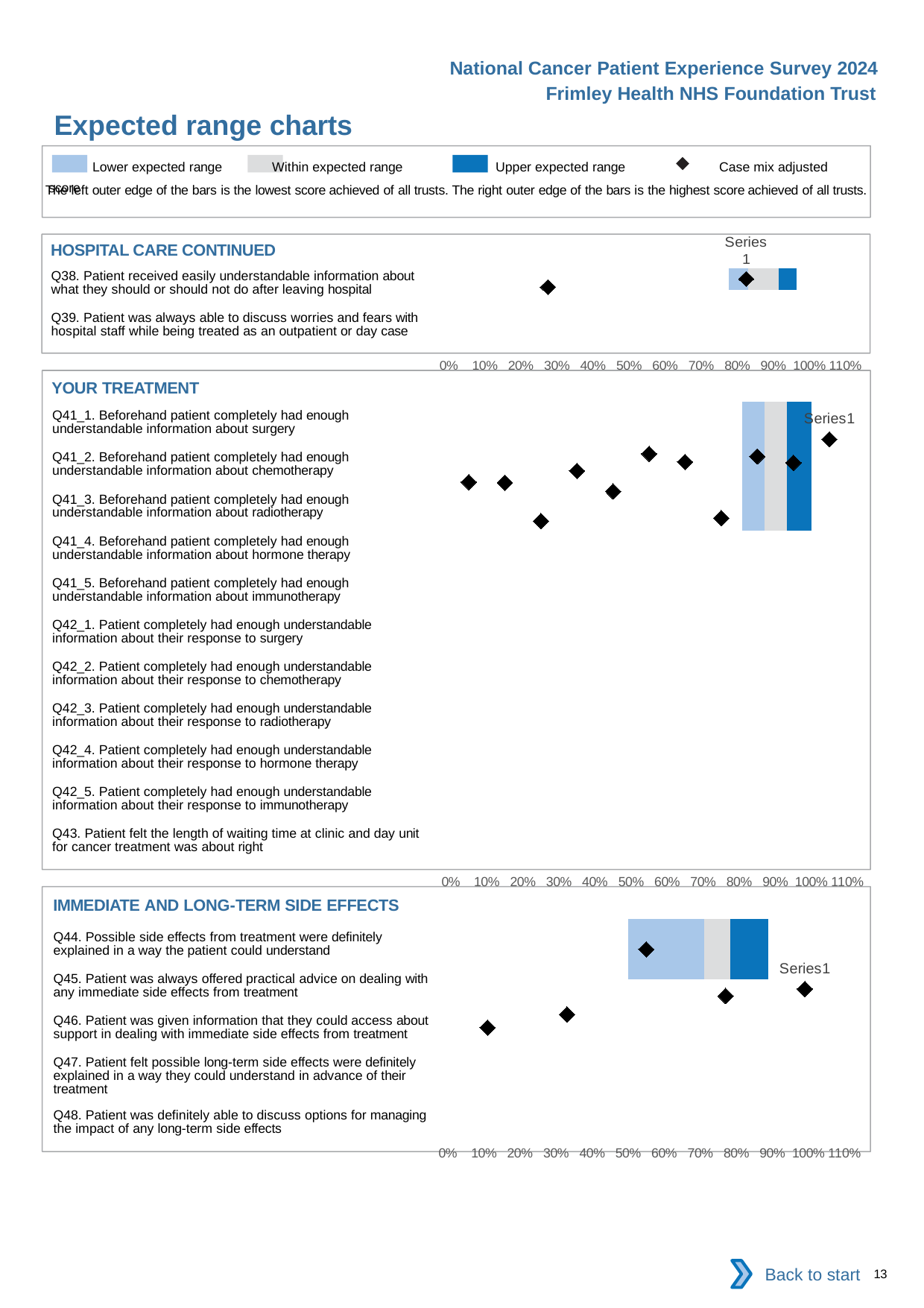
How many question categories are listed in the IMMEDIATE AND LONG-TERM SIDE EFFECTS chart? 5 How many question categories are listed in the YOUR TREATMENT chart? 11 What is the first question category listed in the IMMEDIATE AND LONG-TERM SIDE EFFECTS chart? Q44. Possible side effects from treatment were definitely explained in a way the patient could understand How many question categories are listed in the HOSPITAL CARE CONTINUED chart? 2 What kind of chart is used in the YOUR TREATMENT section? Bar chart What is the title of the middle chart on the slide? YOUR TREATMENT What is the highest tick label shown on the x axis of the IMMEDIATE AND LONG-TERM SIDE EFFECTS chart? 110%